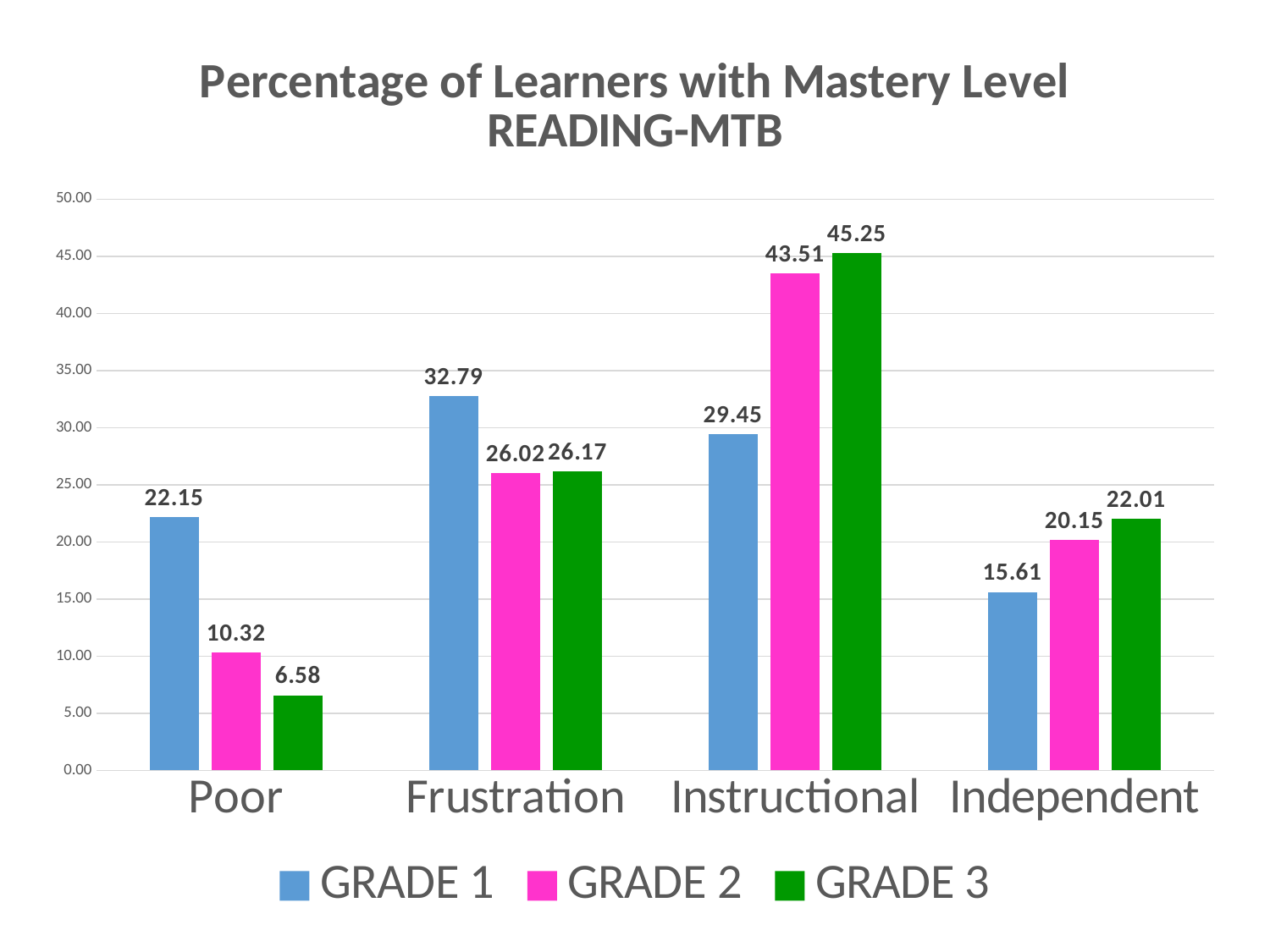
Which category has the lowest value for GRADE 3? Poor What kind of chart is shown on the slide? bar chart What is the value for GRADE 2 in the Poor category? 10.32 How many categories are shown on the x axis? 4 Is the value for GRADE 2 in the Instructional category greater or less than 40.00? greater How many series does the legend list? 3 Which category has the highest value for GRADE 1? Frustration What is the value for GRADE 3 in the Instructional category? 45.25 What is the difference between GRADE 1 and GRADE 3 in the Poor category? 15.57 What is the title of the chart? Percentage of Learners with Mastery Level READING-MTB Which is larger in the Frustration category, GRADE 1 or GRADE 2? GRADE 1 What is the value for GRADE 1 in the Independent category? 15.61